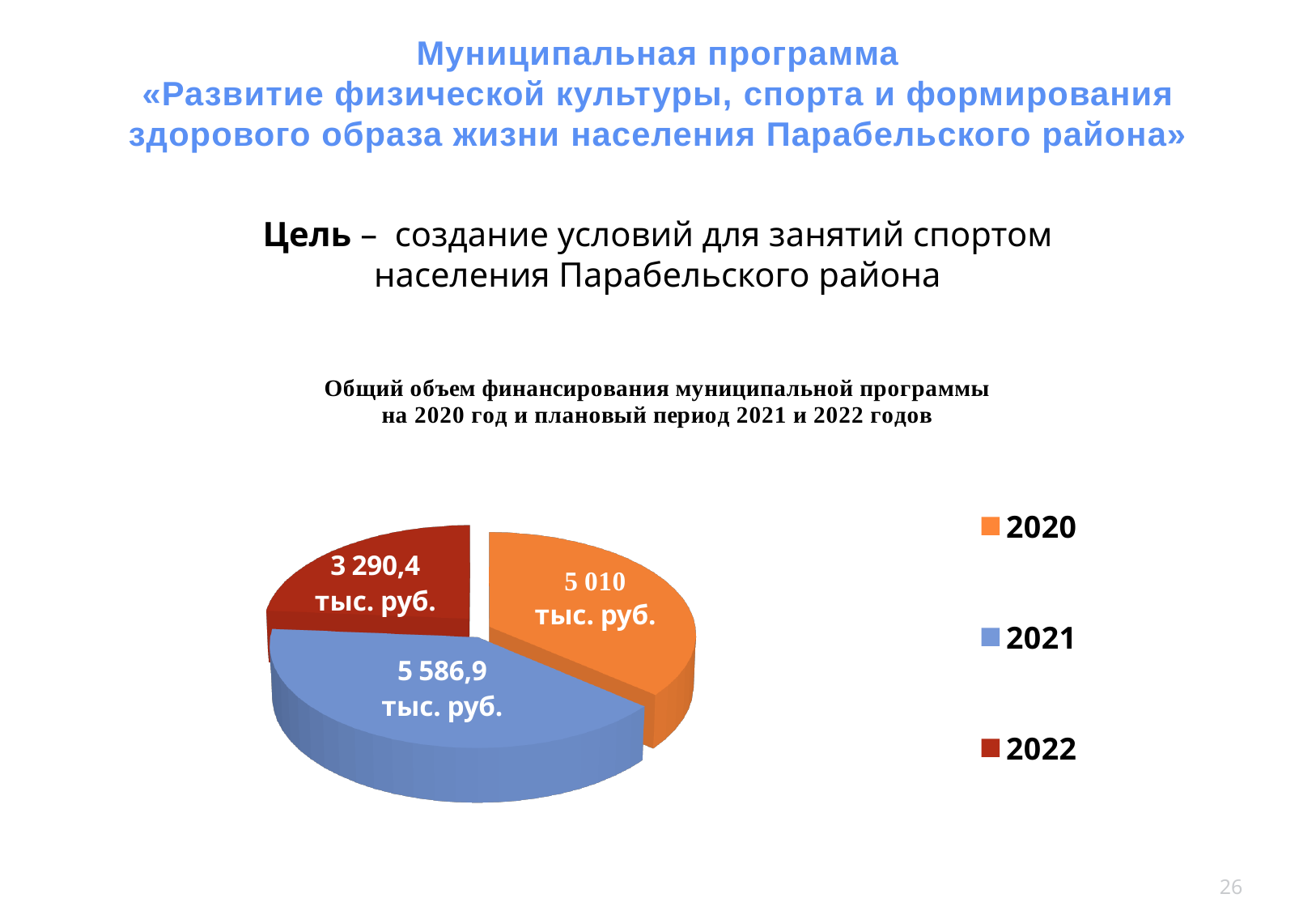
What is the funding amount for 2022 in the pie chart? 3 290,4 тыс. руб. Which is larger, the funding for 2020 or for 2022? 2020 What is the difference between the funding for 2021 and 2020? 576,9 тыс. руб. What is the total funding across all three years shown in the pie chart? 13 887,3 тыс. руб. Which colour represents 2021 in the pie chart legend? Blue Which year has the largest funding amount in the pie chart? 2021 What is the difference between the funding for 2020 and 2022? 1 719,6 тыс. руб. What is the funding amount for 2021 in the pie chart? 5 586,9 тыс. руб. What type of chart is shown on the slide? Pie chart What is the funding amount for 2020 in the pie chart? 5 010 тыс. руб. How many slices does the pie chart have? 3 Which year has the smallest funding amount in the pie chart? 2022